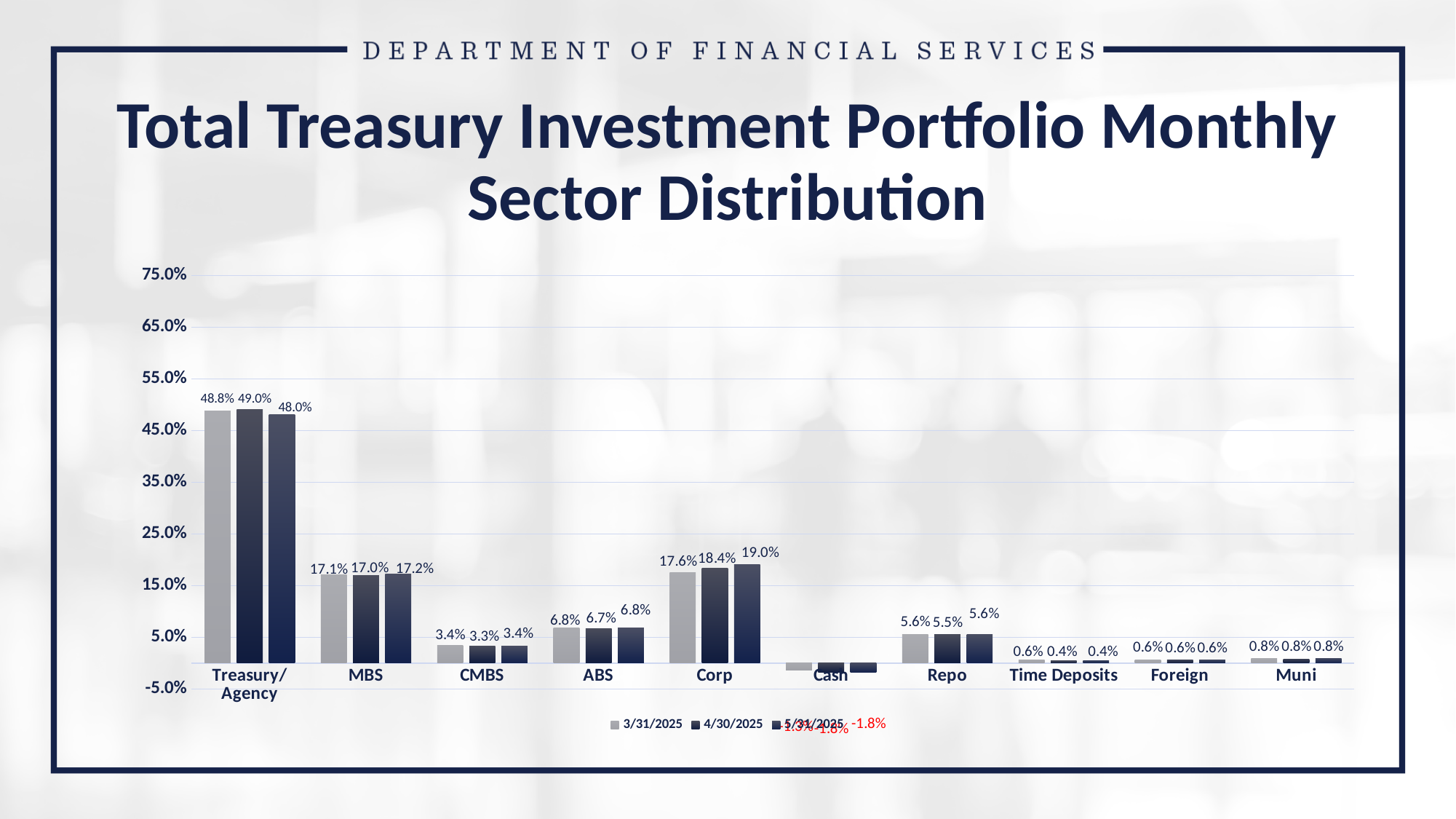
How many sector categories are shown on the x axis? 10 How many series does the legend list? 3 Is the value for Treasury/Agency for 4/30/2025 greater or less than 45.0%? greater Do the Corp values rise or fall from 3/31/2025 to 5/31/2025? Rise What kind of chart is shown on the slide? Bar chart What is the value for Treasury/Agency for 5/31/2025? 48.0% Which sector has the highest value for 3/31/2025? Treasury/Agency What is the value for Time Deposits for 3/31/2025? 0.6% What is the value for Corp for 4/30/2025? 18.4% What is the difference between the Corp values for 5/31/2025 and 3/31/2025? 1.4% Which is larger for 5/31/2025: MBS or Corp? Corp What is the title of the chart? Total Treasury Investment Portfolio Monthly Sector Distribution